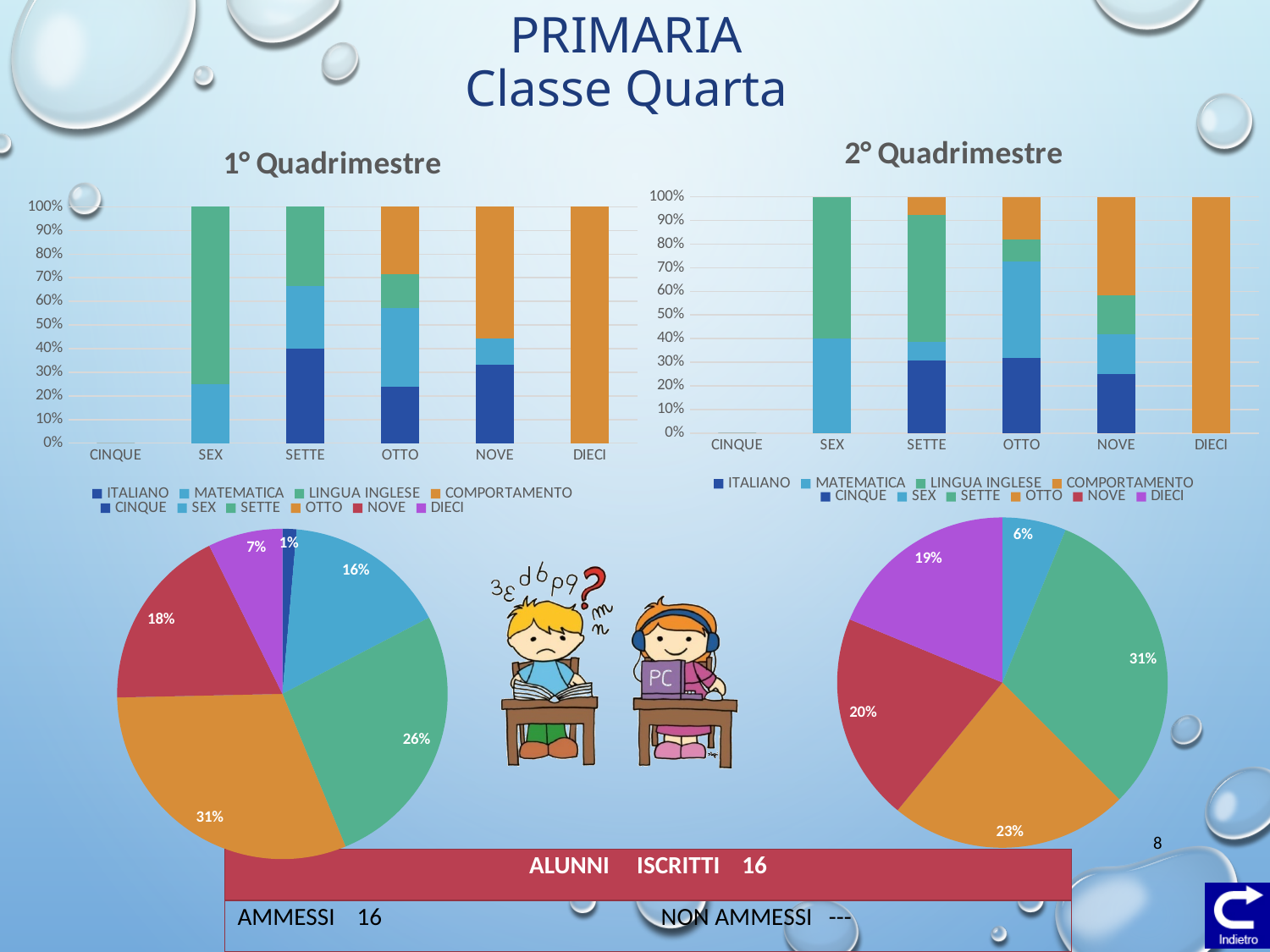
In the left pie chart (below 1° Quadrimestre), which category has the largest slice? OTTO In the right pie chart (below 2° Quadrimestre), which category has the smallest slice? SEX In the left pie chart (below 1° Quadrimestre), what percentage is shown for the CINQUE slice? 1% In the 1° Quadrimestre chart, is the ITALIANO value for SETTE greater or less than 30%? greater In the left pie chart (below 1° Quadrimestre), what is the difference between the SETTE and NOVE slices? 8% What kind of chart is the 2° Quadrimestre chart? Stacked bar chart In the left pie chart (below 1° Quadrimestre), what percentage is shown for the OTTO slice? 31% In the right pie chart (below 2° Quadrimestre), what percentage is shown for the SETTE slice? 31% In the right pie chart (below 2° Quadrimestre), which slice is larger, OTTO or NOVE? OTTO How many series does the legend of the 1° Quadrimestre bar chart list? 4 In the right pie chart (below 2° Quadrimestre), what is the difference between the OTTO and DIECI slices? 4% In the 2° Quadrimestre chart, is the MATEMATICA value for SEX greater or less than 30%? greater